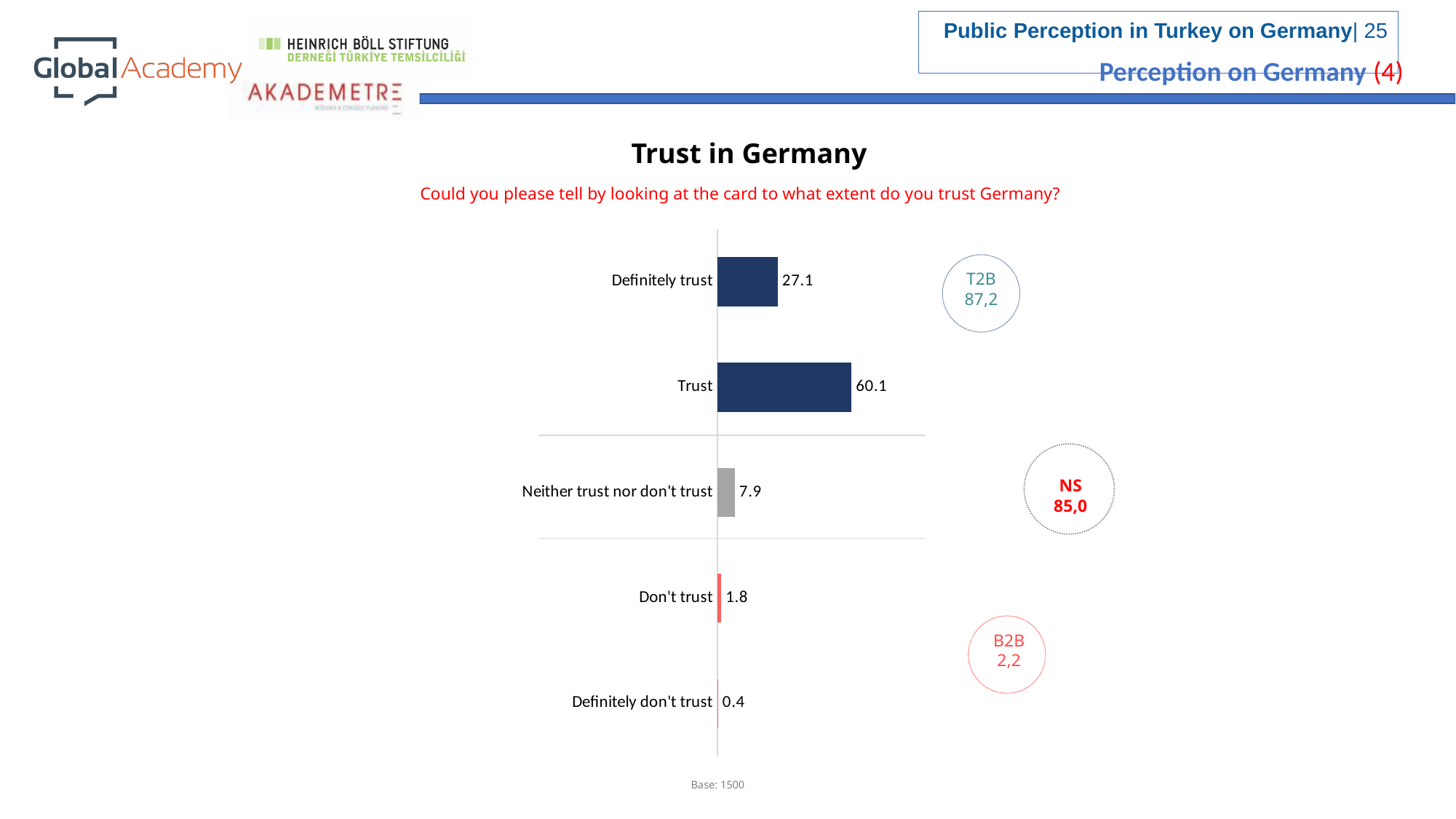
What is the value for "Don't trust"? 1.8 What kind of chart is shown on the slide? Bar chart What is the value for "Neither trust nor don't trust"? 7.9 What is the value for "Definitely trust"? 27.1 Which category has the lowest value? Definitely don't trust Which category has the highest value? Trust What is the value for "Trust"? 60.1 Which is larger, the value for "Neither trust nor don't trust" or the value for "Don't trust"? Neither trust nor don't trust How many categories are shown in the chart? 5 What is the difference between the values for "Trust" and "Definitely trust"? 33.0 What is the title of the chart? Trust in Germany What is the value for "Definitely don't trust"? 0.4